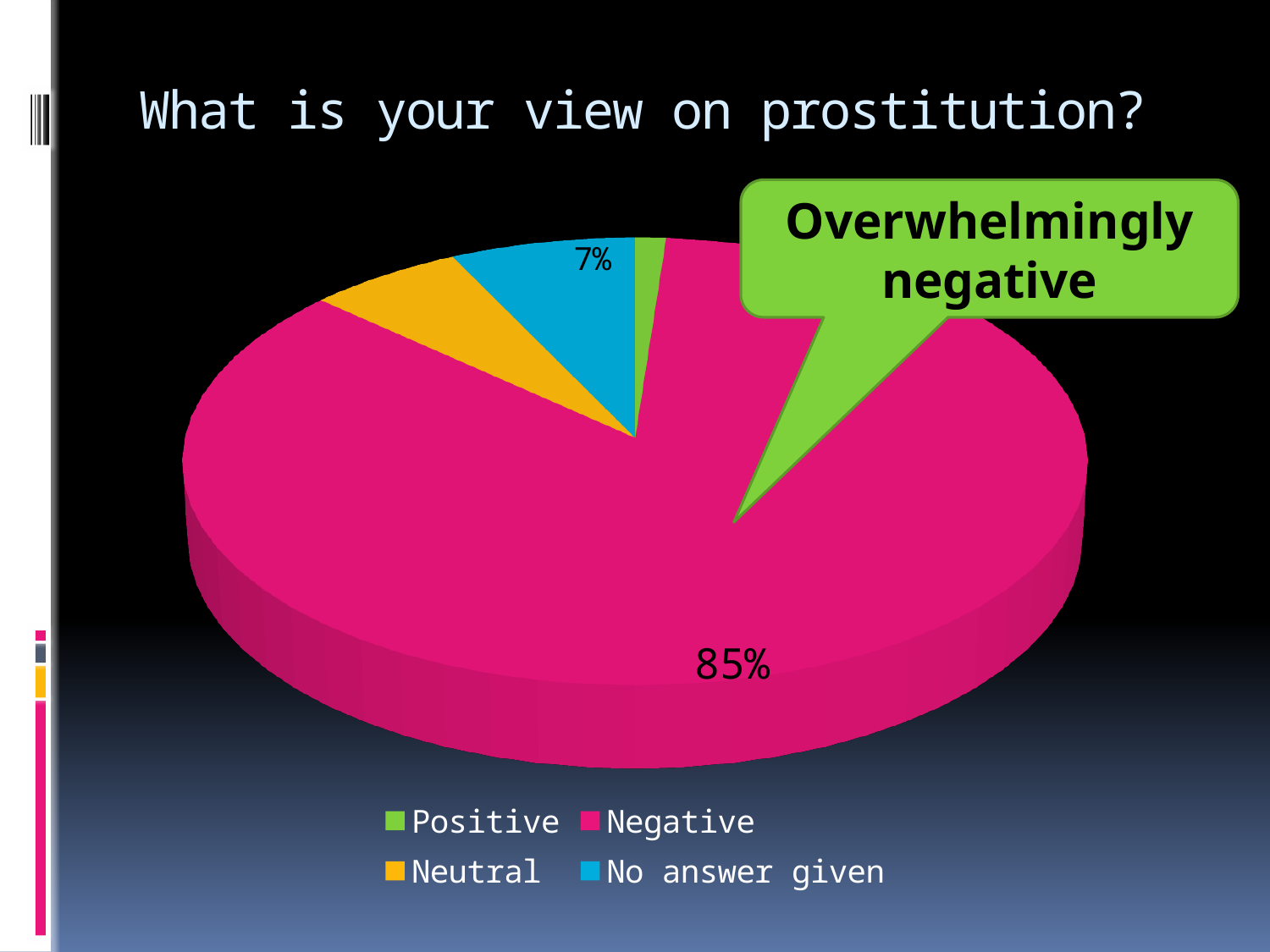
Which category is shown in blue? No answer given By how many percentage points does the Negative share exceed the No answer given share? 78 How many categories does the legend list? 4 What does the green callout on the chart say? Overwhelmingly negative Which is larger, the Negative slice or the Neutral slice? Negative Which category has the largest share of the pie? Negative Which is larger, the No answer given slice or the Positive slice? No answer given What percentage of respondents gave no answer? 7% Which category has the smallest share of the pie? Positive What is the title of the chart? What is your view on prostitution? What percentage of respondents gave a Negative view? 85% What kind of chart is shown on the slide? pie chart